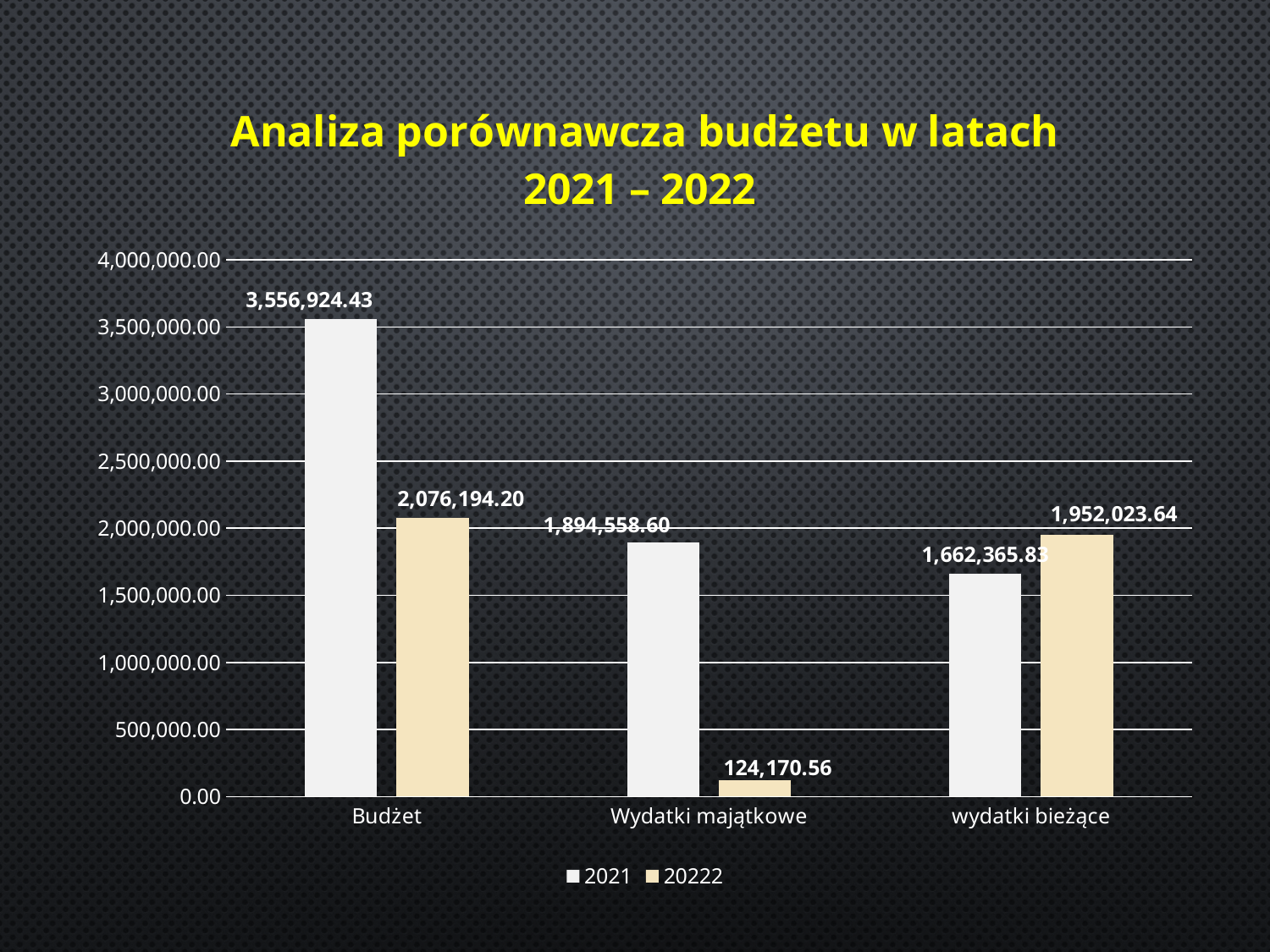
What is the value for Budżet in the 2021 series? 3,556,924.43 What is the value for wydatki bieżące in the second (beige) series? 1,952,023.64 For wydatki bieżące, which series has the larger value, 2021 or the second (beige) series? the second (beige) series What kind of chart is shown on the slide? bar chart Is the 2021 value for wydatki bieżące greater or less than 2,000,000.00? less Which category has the highest value in the 2021 series? Budżet What is the difference between the 2021 and the second-series values for Budżet? 1,480,730.23 What is the value for Budżet in the second (beige) series? 2,076,194.20 What is the value for Wydatki majątkowe in the second (beige) series? 124,170.56 Which category has the lowest value in the second (beige) series? Wydatki majątkowe How many categories are shown on the x axis? 3 What is the value for Wydatki majątkowe in the 2021 series? 1,894,558.60